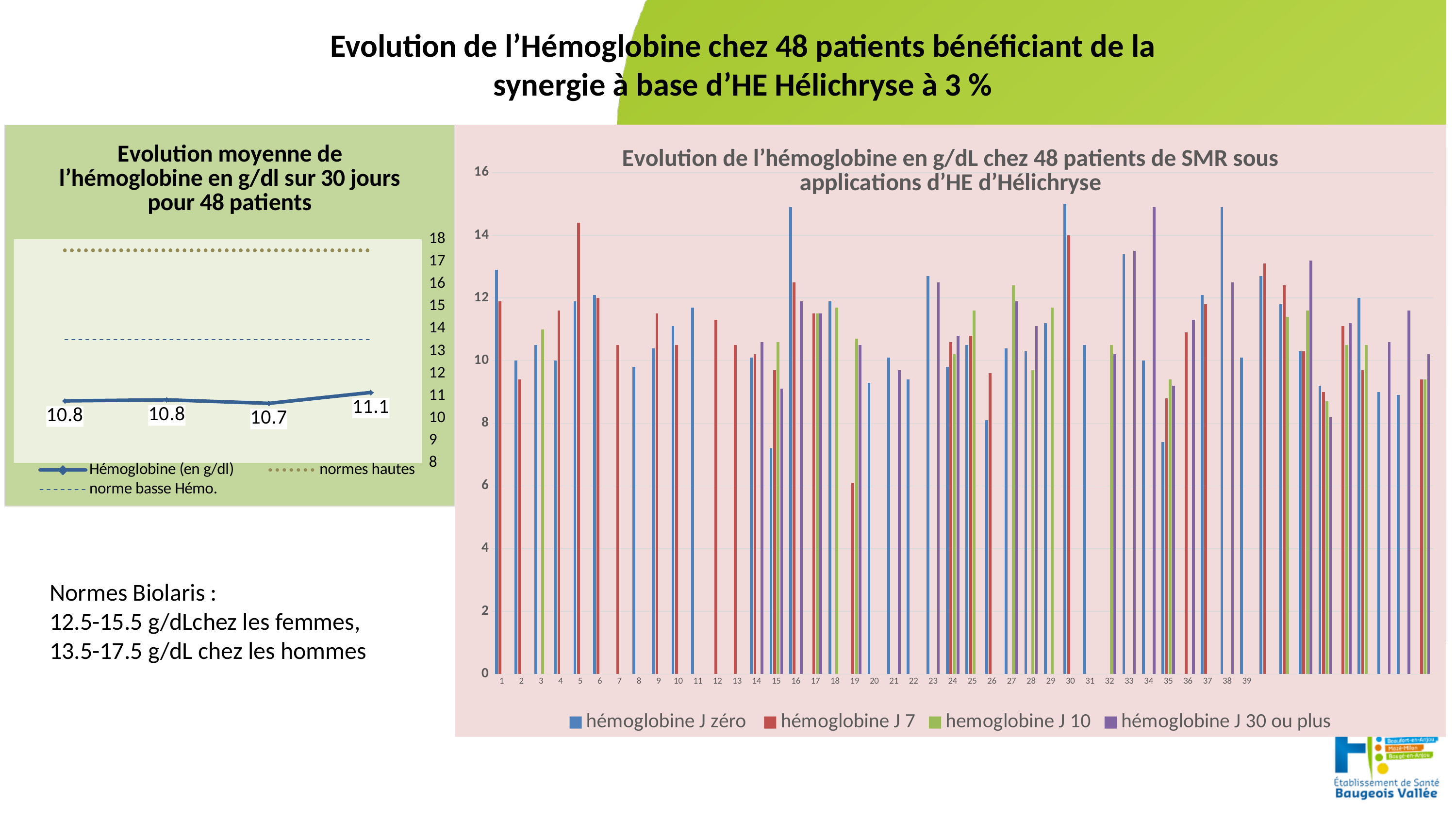
On the left chart 'Evolution moyenne de l'hémoglobine en g/dl sur 30 jours pour 48 patients', how many entries does the legend list? 3 On the right chart 'Evolution de l'hémoglobine en g/dL chez 48 patients de SMR sous applications d'HE d'Hélichryse', is the 'hémoglobine J 7' value for patient 19 greater or less than 8? less On the left chart 'Evolution moyenne de l'hémoglobine en g/dl sur 30 jours pour 48 patients', what is the value of the last data point? 11.1 On the right chart 'Evolution de l'hémoglobine en g/dL chez 48 patients de SMR sous applications d'HE d'Hélichryse', is the 'hémoglobine J zéro' value for patient 16 greater or less than 14? greater On the left chart 'Evolution moyenne de l'hémoglobine en g/dl sur 30 jours pour 48 patients', how many data points are labelled on the hemoglobin line? 4 What kind of chart is the left chart 'Evolution moyenne de l'hémoglobine en g/dl sur 30 jours pour 48 patients'? line chart On the left chart 'Evolution moyenne de l'hémoglobine en g/dl sur 30 jours pour 48 patients', what is the difference between the last value (11.1) and the third value (10.7)? 0.4 On the right chart 'Evolution de l'hémoglobine en g/dL chez 48 patients de SMR sous applications d'HE d'Hélichryse', how many series does the legend list? 4 On the left chart 'Evolution moyenne de l'hémoglobine en g/dl sur 30 jours pour 48 patients', what is the value of the first data point? 10.8 What kind of chart is the right chart 'Evolution de l'hémoglobine en g/dL chez 48 patients de SMR sous applications d'HE d'Hélichryse'? bar chart On the left chart 'Evolution moyenne de l'hémoglobine en g/dl sur 30 jours pour 48 patients', what is the lowest labelled hemoglobin value? 10.7